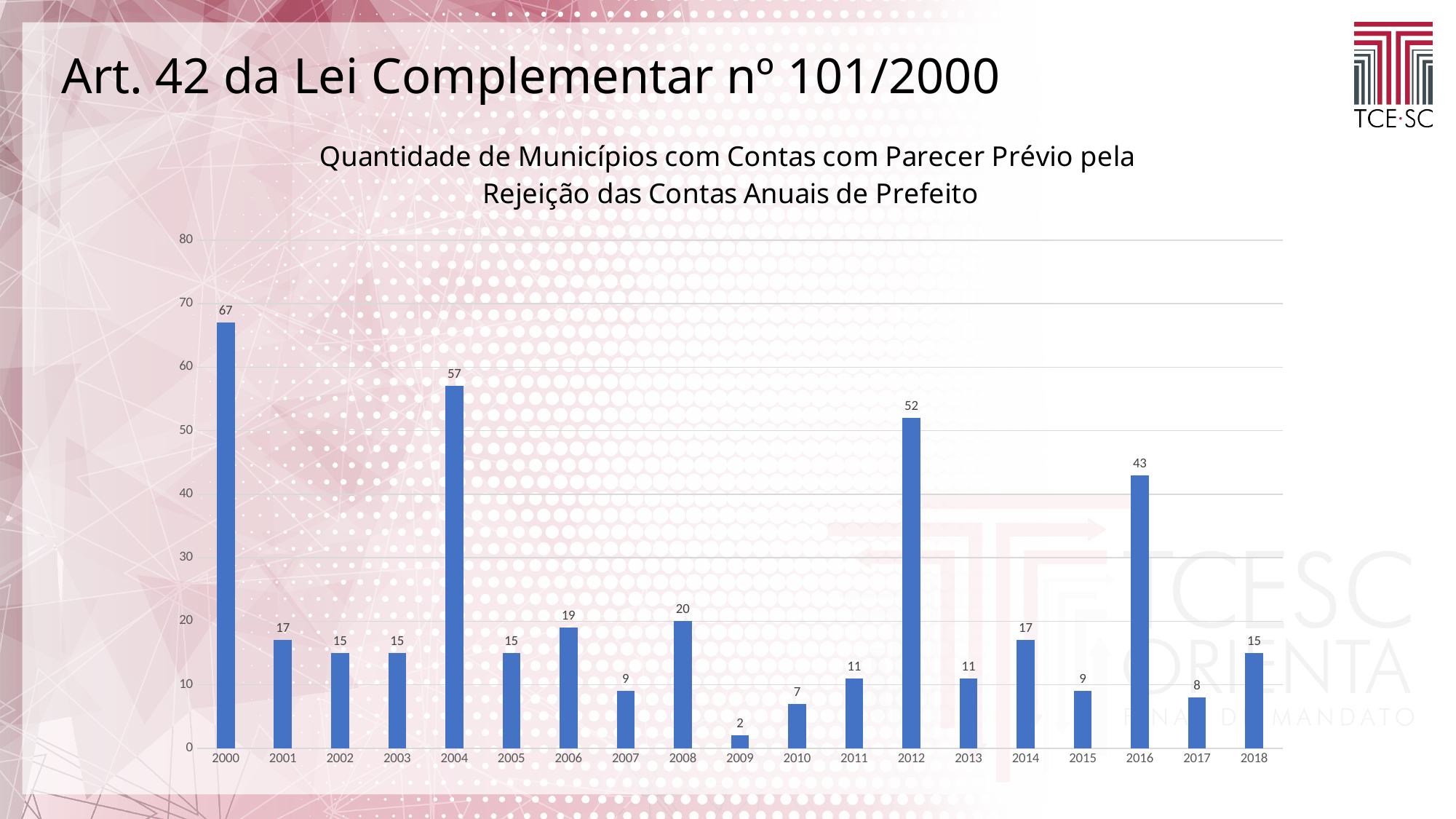
Which year has the highest value? 2000 What is the value for 2012? 52 What is the value for 2009? 2 Which is larger, the value for 2008 or the value for 2006? 2008 Is the value for 2012 greater or less than 50? greater Do the values rise or fall from 2016 to 2017? Fall How many years are shown on the x axis? 19 Which year has the lowest value? 2009 What is the title of the chart? Quantidade de Municípios com Contas com Parecer Prévio pela Rejeição das Contas Anuais de Prefeito What kind of chart is shown? Bar chart What is the value for 2000? 67 What is the difference between the values for 2004 and 2016? 14